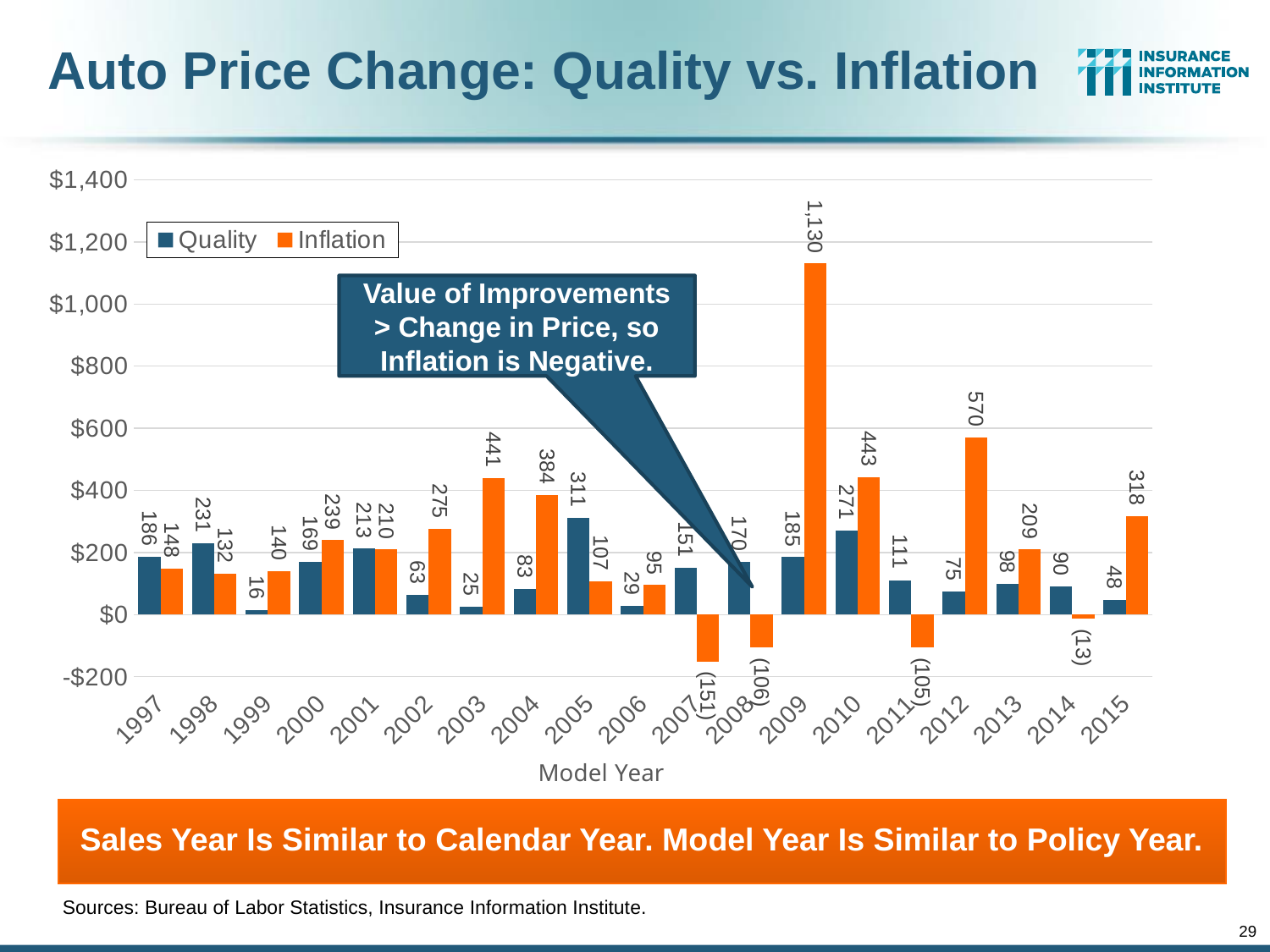
What is the Inflation value for model year 2014? (13) For model year 2003, which is larger, Quality or Inflation? Inflation How many series does the legend list? 2 What kind of chart is shown on the slide? Bar chart How many model years are shown on the x axis? 19 What is the x-axis title of the chart? Model Year Which model year has the highest Inflation value? 2009 What is the Inflation value for model year 2009? 1,130 Which colour represents the Inflation series in the chart? Orange What is the difference between the Inflation value and the Quality value for model year 2012? 495 Which model year has the lowest Quality value? 1999 What is the Quality value for model year 2005? 311